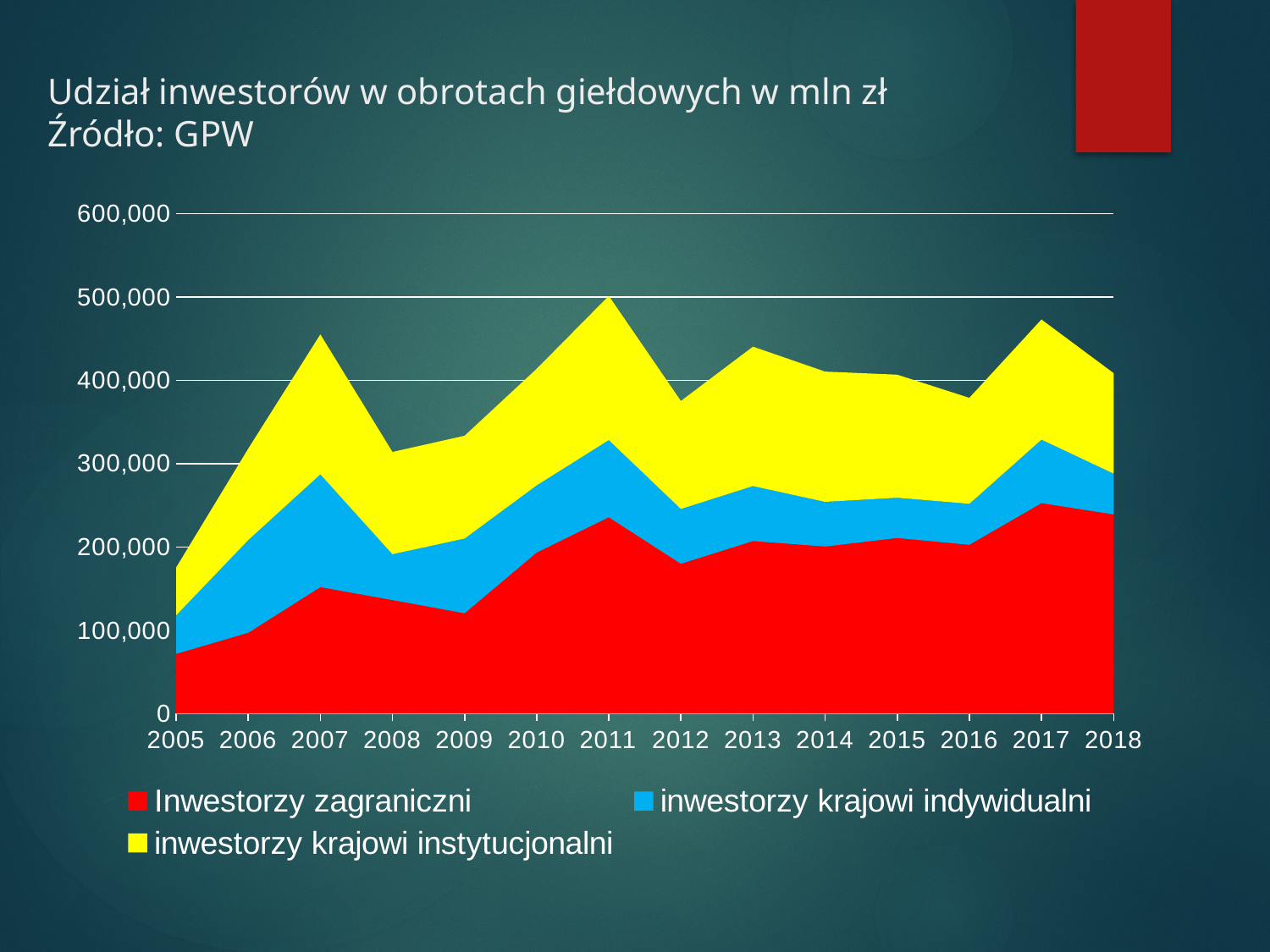
How many years are shown on the x axis of the chart? 14 Which year has the larger total of all three series, 2007 or 2008? 2007 How many series does the chart's legend list? 3 What kind of chart is shown on the slide? Stacked area chart Which series is shown in red in the chart? Inwestorzy zagraniczni In which year is the total of all three series highest? 2011 Is the value for Inwestorzy zagraniczni in 2017 greater or less than 200,000? greater In which year is the value for Inwestorzy zagraniczni lowest? 2005 In which year is the total of all three series lowest? 2005 Is the total of all three series in 2007 greater or less than 400,000? greater What is the title of the chart on the slide? Udział inwestorów w obrotach giełdowych w mln zł Is the total of all three series in 2005 greater or less than 200,000? less